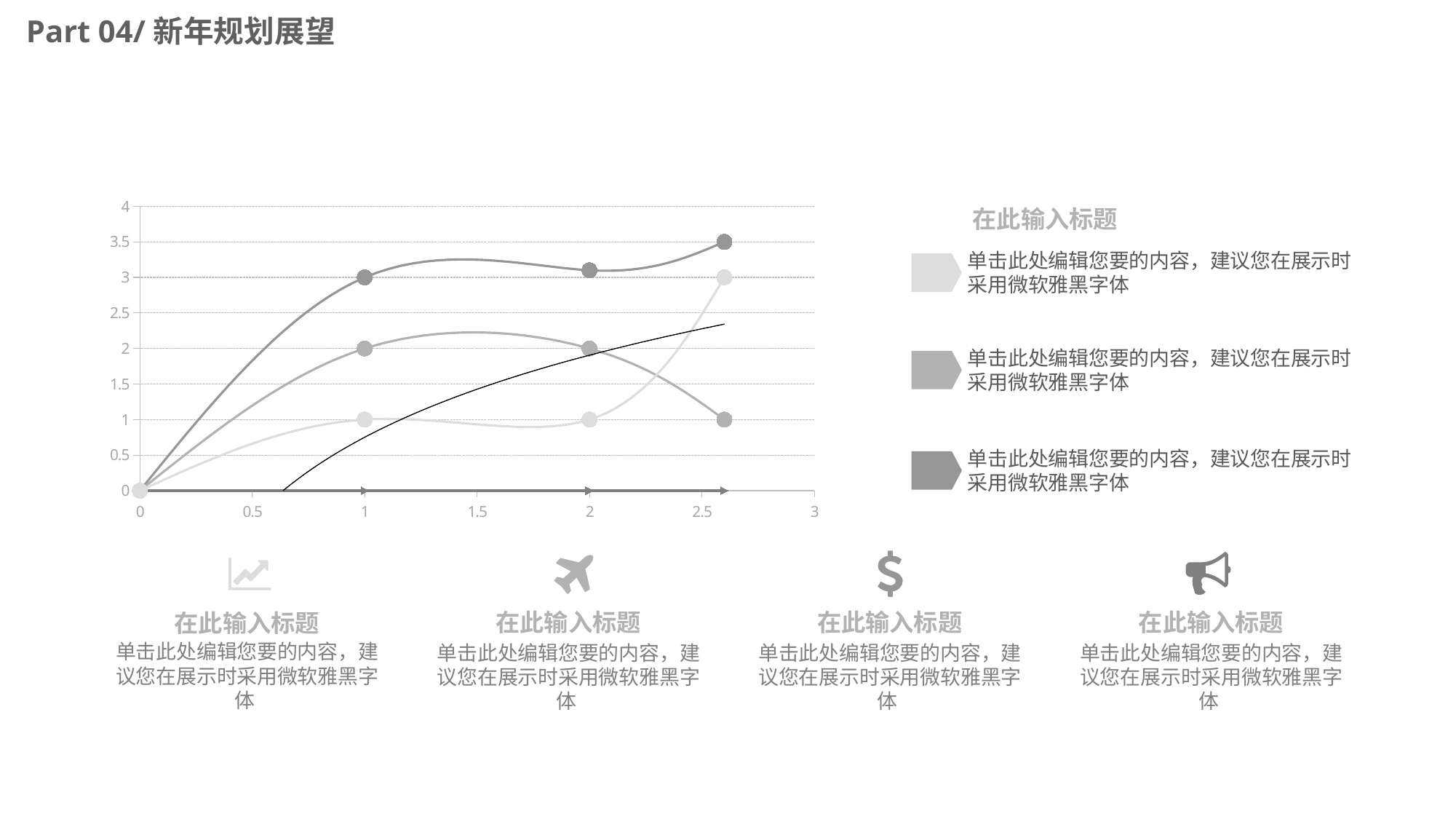
Is the value of the medium-grey line at x = 2.6 greater or less than 2? less What is the highest value shown on the vertical axis of the chart? 4 Is the value of the lightest line at x = 2 greater or less than 2? less What is the value of the darkest line at x = 1? 3 What kind of chart is shown on the slide? line chart What is the highest value shown on the horizontal axis of the chart? 3 What is the value of the lightest line at its last marked point (x = 2.6)? 3 What is the value of the lightest line at x = 1? 1 At x = 2.6, which line has the larger value, the medium-grey line or the lightest line? the lightest line At x = 1, which line has the larger value, the darkest line or the lightest line? the darkest line Does the medium-grey line rise or fall between x = 2 and x = 2.6? fall Is the value of the darkest line at x = 2.6 greater or less than 3? greater